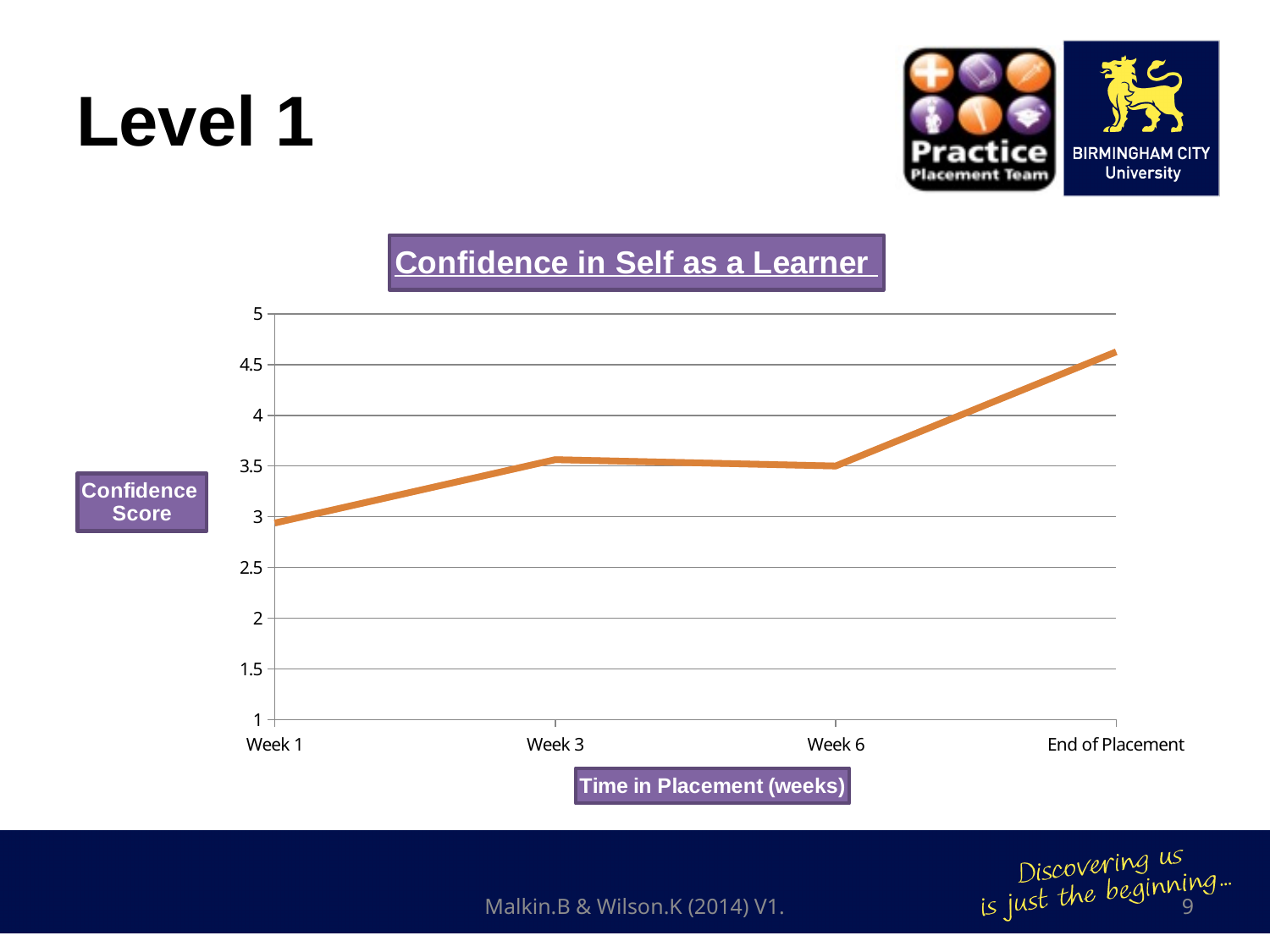
Is the confidence score at Week 1 greater or less than 3.5? less What kind of chart is shown on the slide? line chart What is the title of the chart? Confidence in Self as a Learner Which has the higher confidence score, Week 1 or Week 3? Week 3 How many time points are plotted on the chart? 4 At which time point is the confidence score lowest? Week 1 What is the label on the x axis of the chart? Time in Placement (weeks) Is the confidence score at Week 3 greater or less than 3? greater At which time point is the confidence score highest? End of Placement Does the confidence score generally rise or fall from Week 1 to End of Placement? rise Is the confidence score at Week 6 greater or less than 4? less